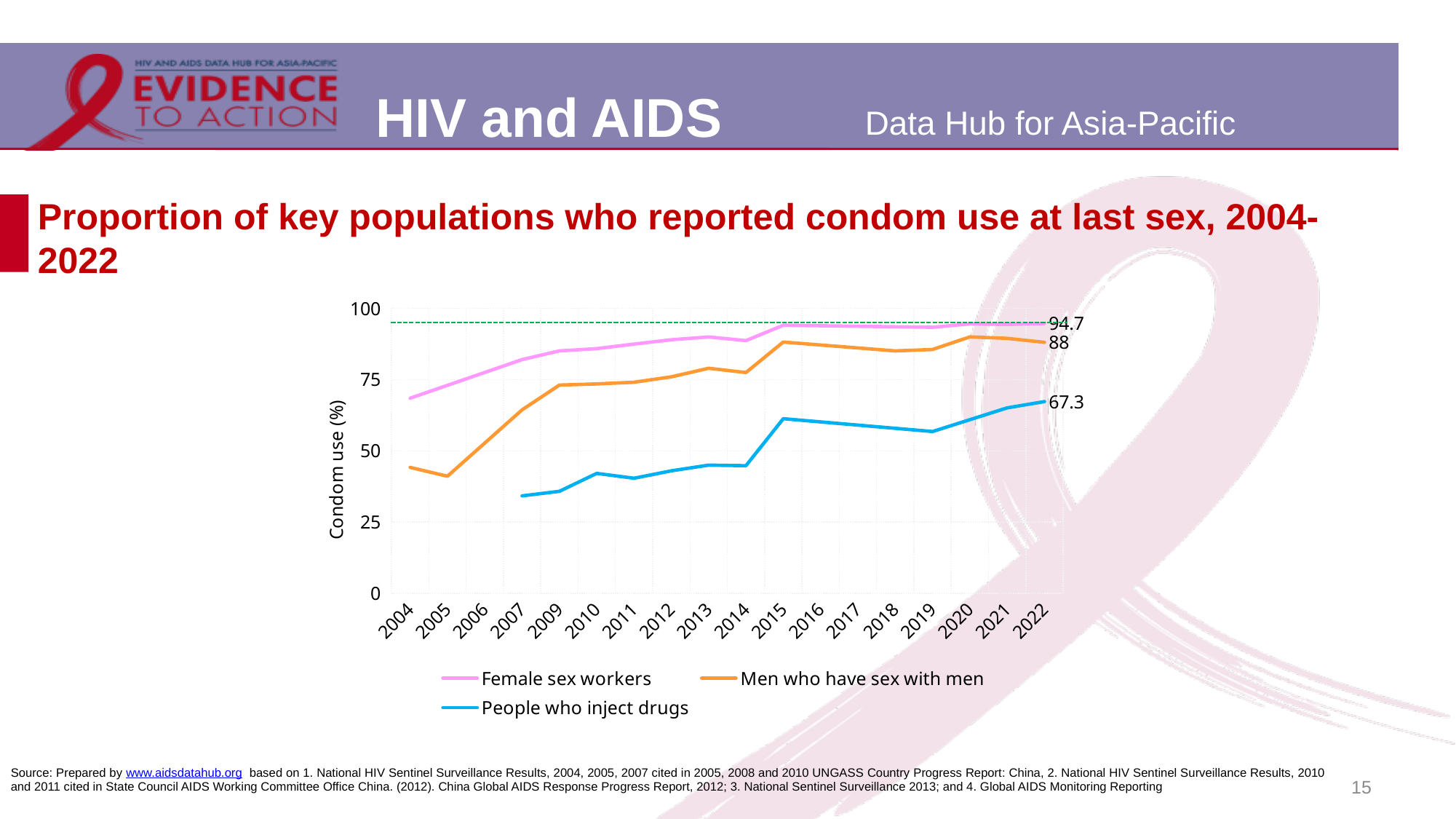
Is the value for People who inject drugs in 2007 greater or less than 50? less What kind of chart is shown on the slide? line chart Which series has the lowest value in 2022? People who inject drugs In 2022, which is larger: the value for Men who have sex with men or the value for People who inject drugs? Men who have sex with men What is the difference between the 2022 values for Female sex workers and Men who have sex with men? 6.7 Which series has the highest value in 2022? Female sex workers What is the value for Female sex workers in 2022? 94.7 What is the value for Men who have sex with men in 2022? 88 How many series does the legend list? 3 What is the value for People who inject drugs in 2022? 67.3 What is the difference between the 2022 values for Female sex workers and People who inject drugs? 27.4 Is the value for Female sex workers in 2004 greater or less than 50? greater